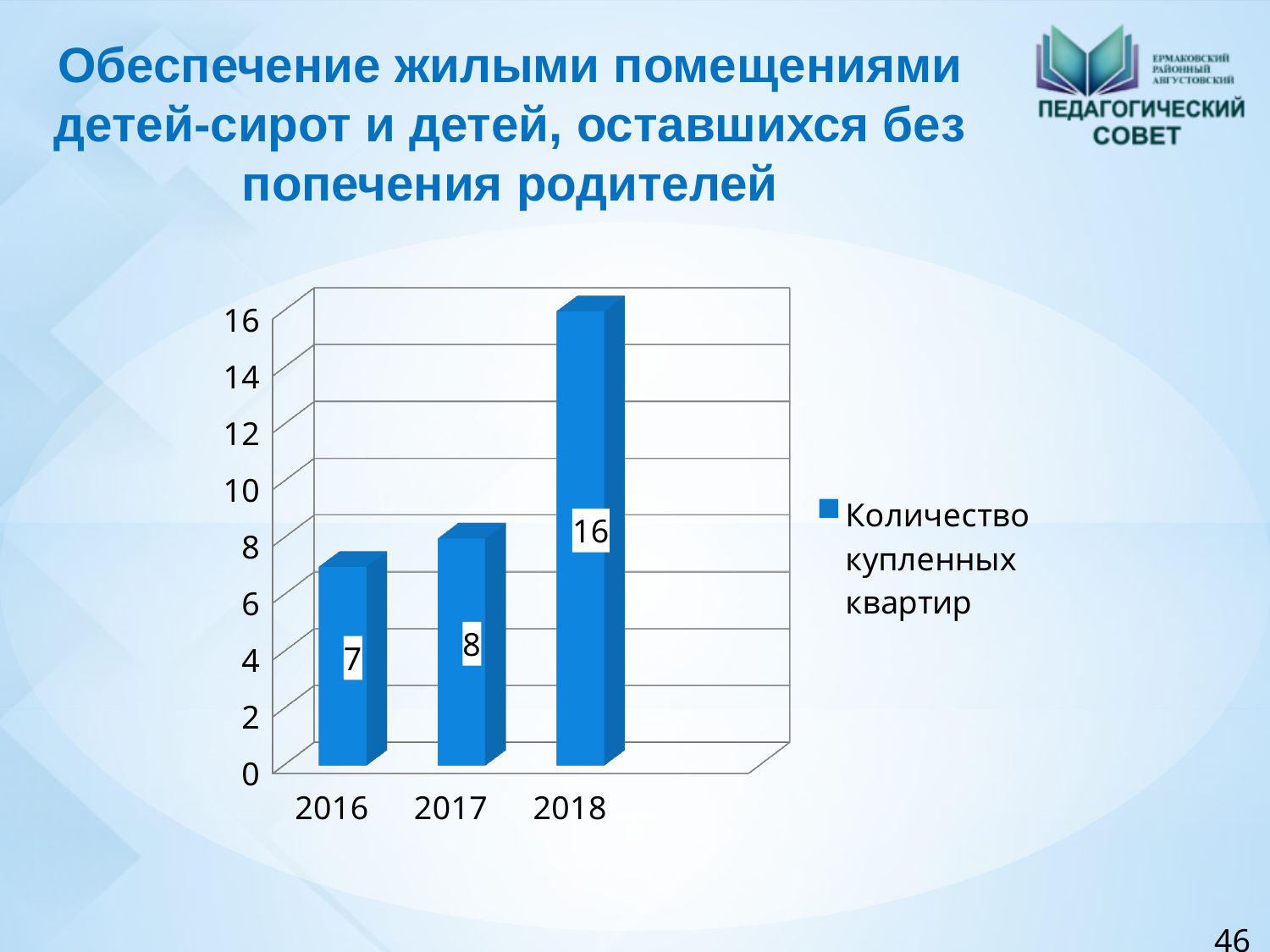
What is the difference between the values for 2018 and 2017? 8 Which year has the lowest value? 2016 How many years are shown on the x axis? 3 What kind of chart is shown on the slide? bar chart How many series does the legend list? 1 Which is larger, the value for 2016 or the value for 2018? 2018 What is the difference between the values for 2017 and 2016? 1 What is the value for 2017? 8 What is the value for 2016? 7 Which year has the highest value? 2018 What is the value for 2018? 16 Do the values rise or fall from 2016 to 2018? rise